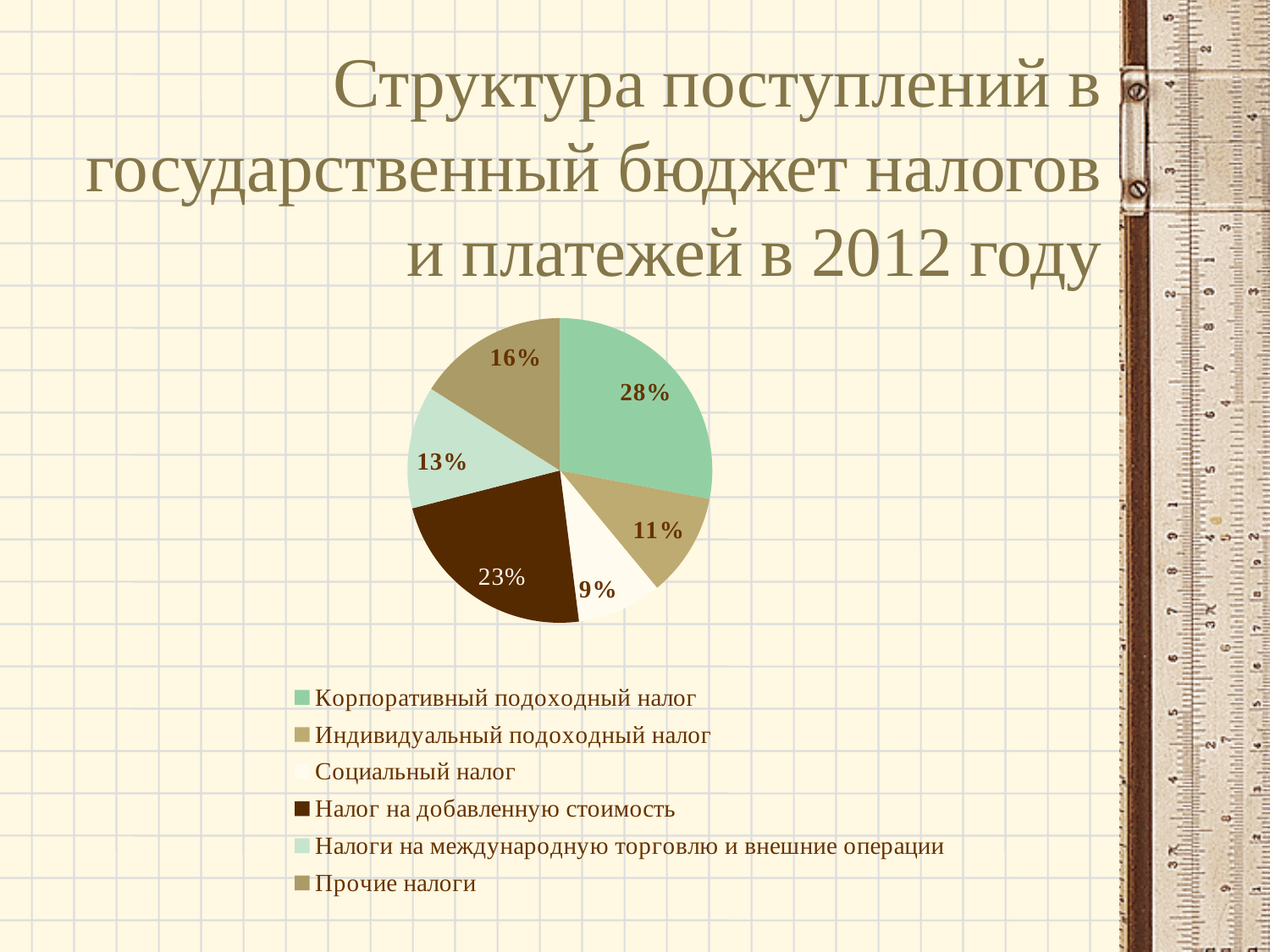
What is the value shown for Налог на добавленную стоимость? 23% Which year does the chart title refer to? 2012 What is the value shown for Налоги на международную торговлю и внешние операции? 13% Which category has the smallest slice of the pie? Социальный налог What is the value shown for Прочие налоги? 16% What is the value shown for Социальный налог? 9% What is the difference between the shares of Корпоративный подоходный налог and Индивидуальный подоходный налог? 17% What share of the pie does Корпоративный подоходный налог have? 28% What type of chart is shown on the slide? Pie chart Which category has the largest slice of the pie? Корпоративный подоходный налог Which is larger: the share of Прочие налоги or the share of Налоги на международную торговлю и внешние операции? Прочие налоги How many slices does the pie chart have? 6